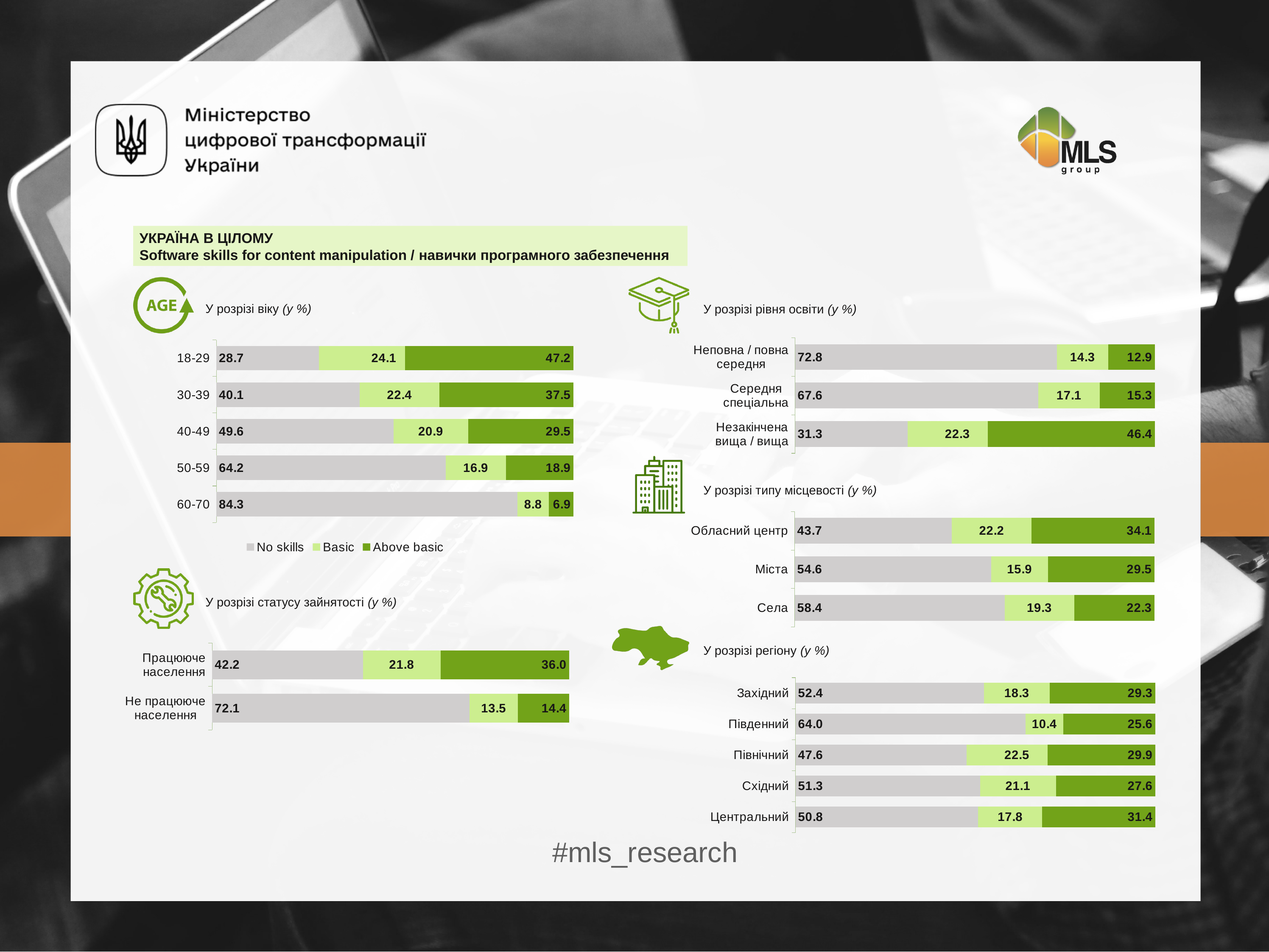
In the employment status chart (У розрізі статусу зайнятості), what is the 'No skills' value for Не працююче населення? 72.1 In the education chart (У розрізі рівня освіти), what is the 'Basic' value for Середня спеціальна? 17.1 In the locality type chart (У розрізі типу місцевості), which is larger: the 'Above basic' value for Обласний центр or for Села? Обласний центр How many series does the legend list (No skills, Basic, Above basic)? 3 In the age chart (У розрізі віку), which age group has the highest 'No skills' value? 60-70 In the age chart (У розрізі віку), how many age groups are shown? 5 In the education chart (У розрізі рівня освіти), which education level has the lowest 'No skills' value? Незакінчена вища / вища In the locality type chart (У розрізі типу місцевості), what is the total of the stacked bar for Міста? 100.0 What kind of chart is used for the region breakdown (У розрізі регіону)? Stacked bar chart In the region chart (У розрізі регіону), which region has the lowest 'Basic' value? Південний In the age chart (У розрізі віку), what is the 'Above basic' value for the 18-29 group? 47.2 In the age chart (У розрізі віку), what is the difference between the 'No skills' values for 60-70 and 18-29? 55.6